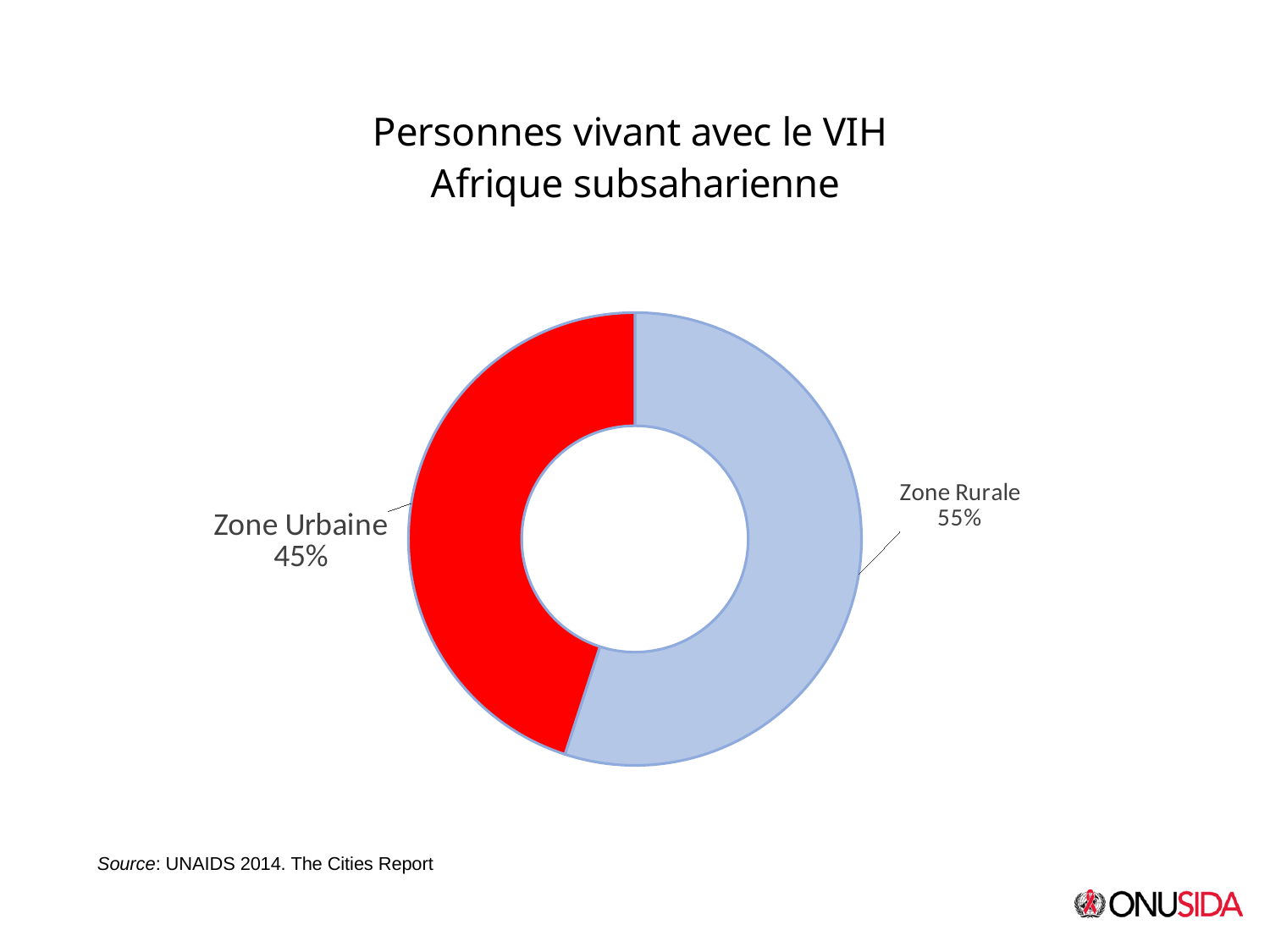
What is the difference in percentage points between the Zone Rurale and Zone Urbaine shares? 10 percentage points Which zone has the larger share of people living with HIV? Zone Rurale What colour is the Zone Urbaine slice? Red What is the total of the two slices shown? 100% What share of people living with HIV in sub-Saharan Africa are in Zone Rurale? 55% What kind of chart is shown on the slide? Doughnut (pie) chart How many slices does the chart have? 2 Is the share for Zone Rurale larger or smaller than the share for Zone Urbaine? larger Is the share for Zone Urbaine greater or less than 50%? less What share of people living with HIV in sub-Saharan Africa are in Zone Urbaine? 45% Which zone has the smaller share of people living with HIV? Zone Urbaine What is the title of the chart? Personnes vivant avec le VIH Afrique subsaharienne